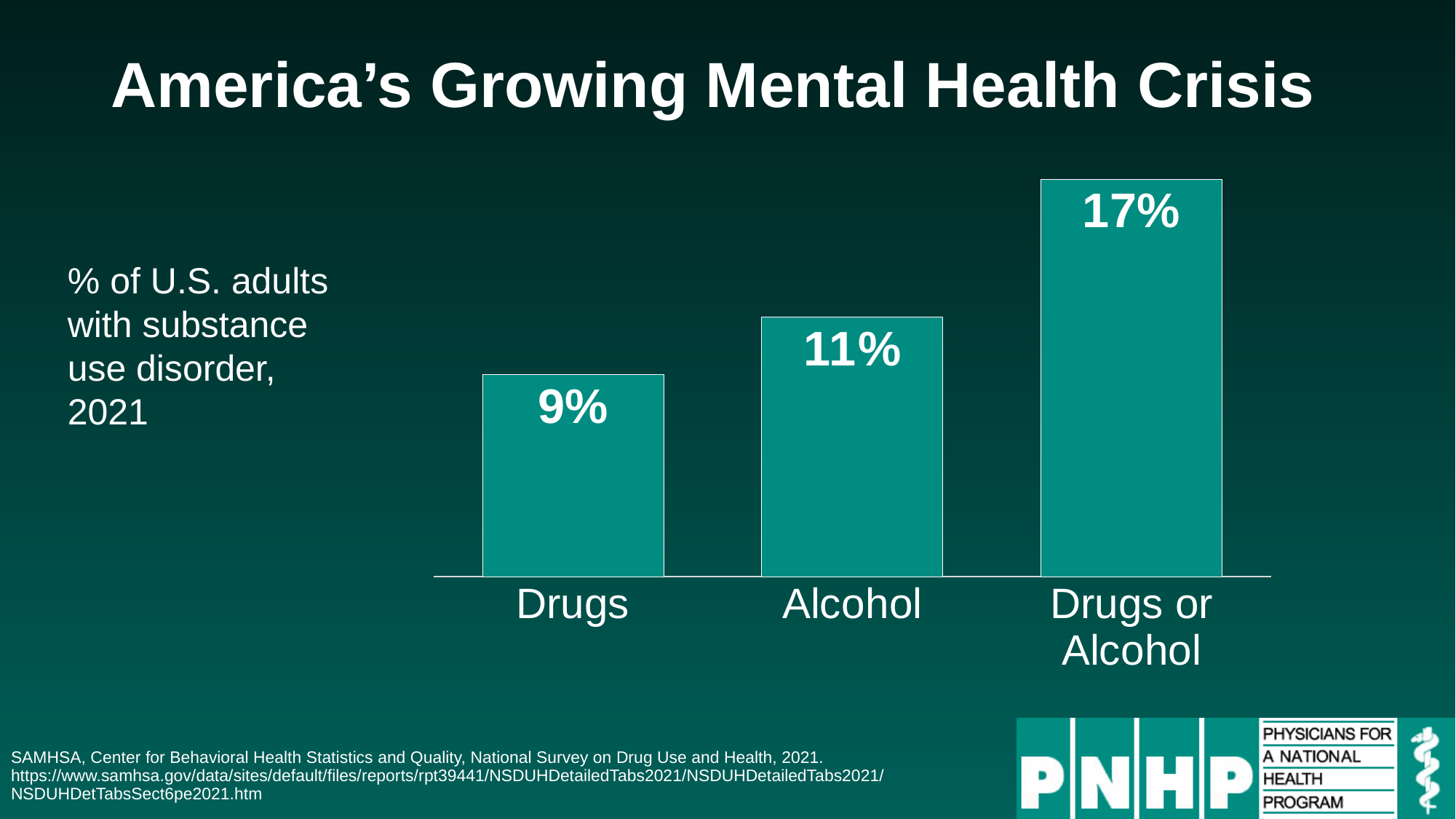
Do the values rise or fall from left to right across the categories? Rise What is the difference between the Drugs or Alcohol value and the Drugs value? 8% How many categories are shown in the chart? 3 What is the value shown for Alcohol? 11% Which category has the lowest value? Drugs What does the chart measure, according to the text on the left of the slide? % of U.S. adults with substance use disorder, 2021 What percentage of U.S. adults had a drug use disorder in 2021 according to the chart? 9% What is the value shown for Drugs or Alcohol? 17% What is the difference between the Alcohol value and the Drugs value? 2% What kind of chart is shown on the slide? Bar chart Which is larger, the value for Alcohol or the value for Drugs? Alcohol Which category has the highest value? Drugs or Alcohol